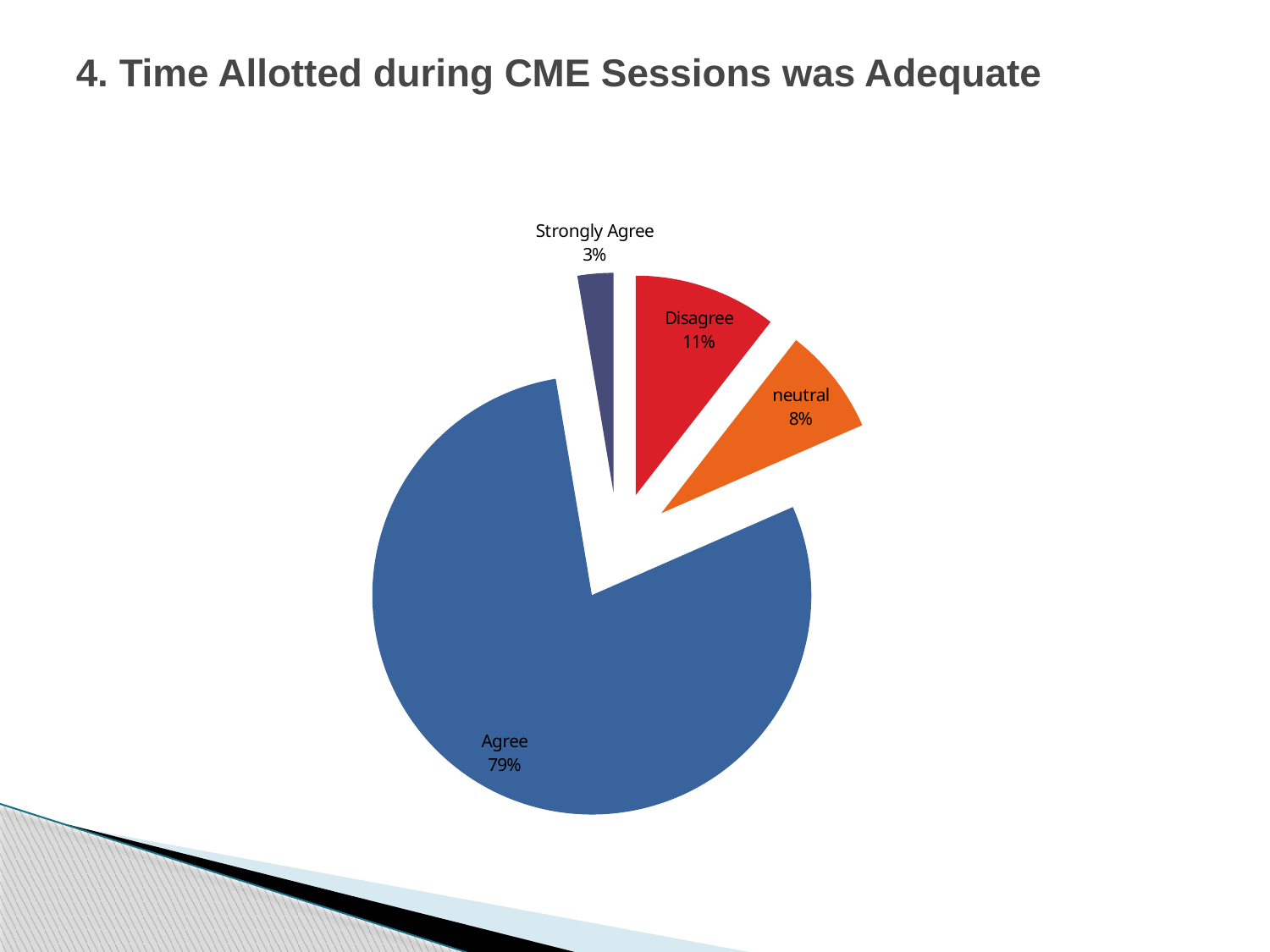
What is the title of the slide? 4. Time Allotted during CME Sessions was Adequate What is the difference in percentage points between Disagree and neutral? 3 How many slices does the pie chart have? 4 What percentage of respondents chose Disagree? 11% Which response category has the largest share of the pie? Agree What percentage of respondents chose Strongly Agree? 3% What percentage of respondents chose Agree? 79% Which is larger, the share for Disagree or the share for neutral? Disagree Which response category has the smallest share of the pie? Strongly Agree What is the difference in percentage points between Agree and Disagree? 68 What percentage of respondents chose neutral? 8% What type of chart is shown on the slide? Pie chart